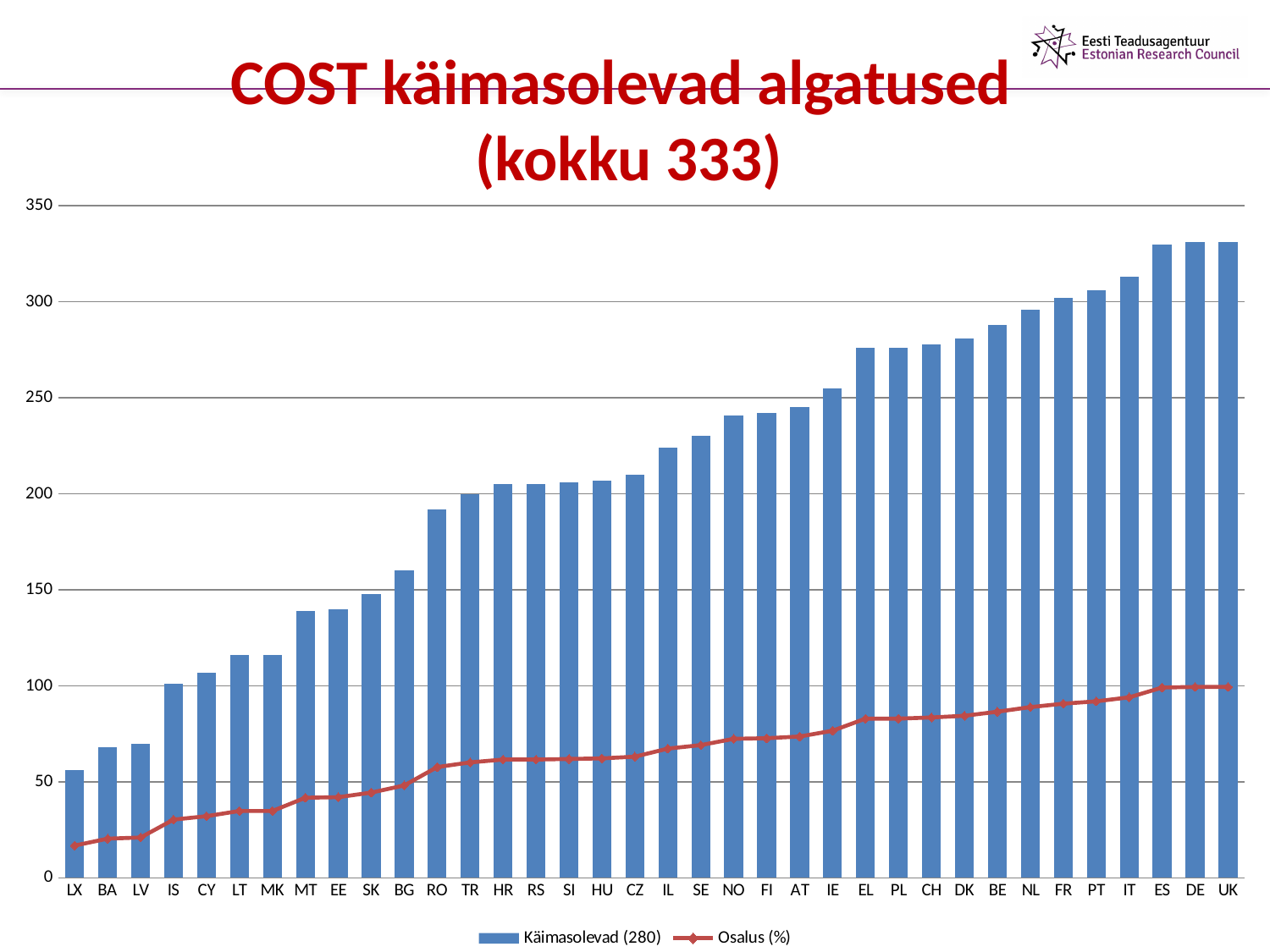
Do the Käimasolevad bars rise or fall from left to right along the x axis? rise What is the name of the series drawn as a red line? Osalus (%) Is the Käimasolevad value for UK greater or less than 300? greater What is the title of the chart? COST käimasolevad algatused (kokku 333) How many series does the legend list? 2 Which has the larger Käimasolevad bar, EE or IT? IT Is the Käimasolevad value for LX greater or less than 100? less How many countries are shown along the x axis? 36 Is the Käimasolevad value for EE greater or less than 150? less What kind of chart is shown on the slide? combination bar and line chart Which country has the lowest bar for Käimasolevad? LX